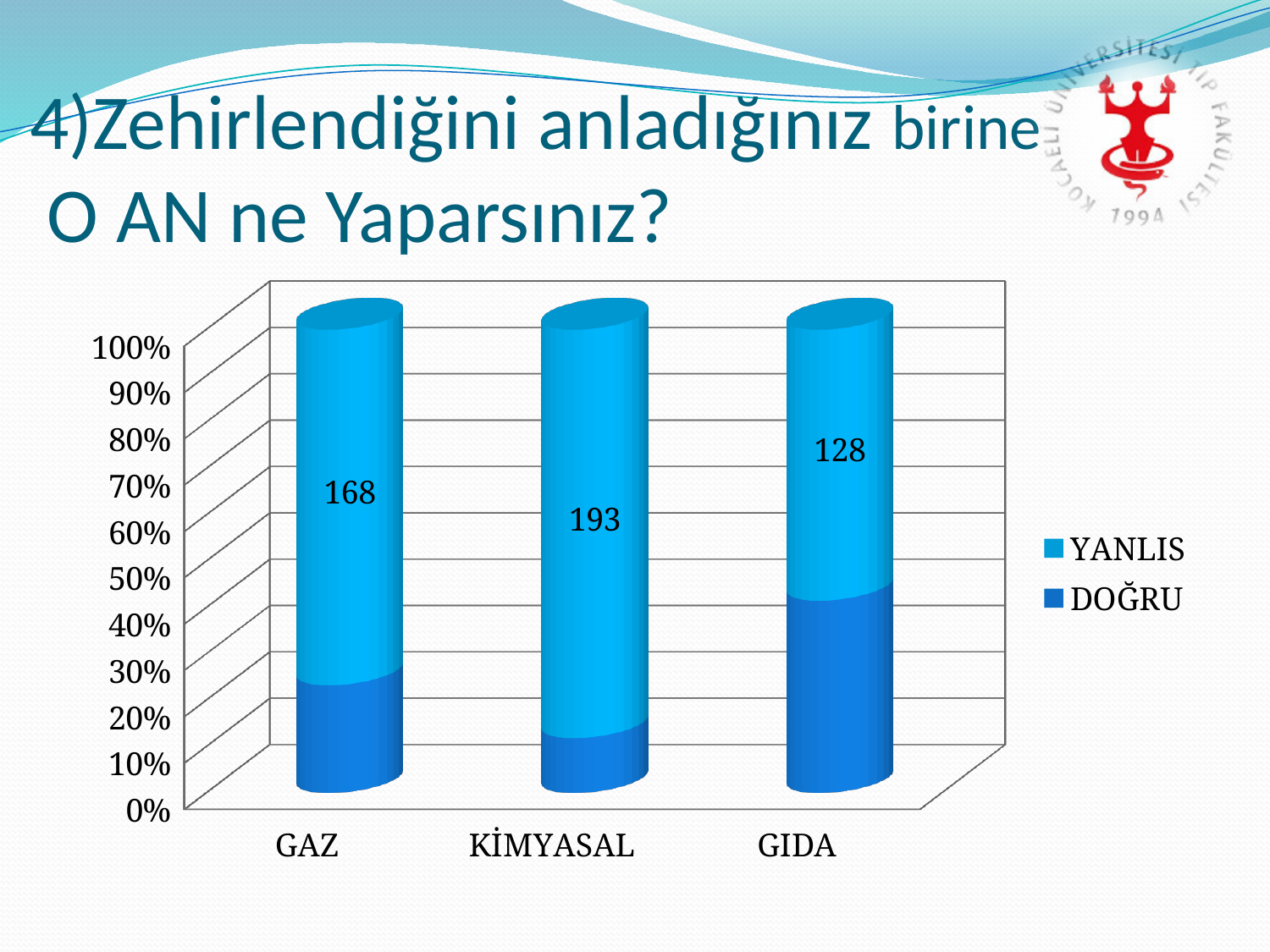
Is the DOĞRU share for GIDA greater or less than 40%? greater Is the DOĞRU share for KİMYASAL greater or less than 30%? less What is the YANLIS value for GAZ? 168 What kind of chart is shown on the slide? Stacked bar chart What is the YANLIS value for KİMYASAL? 193 Which category has the lowest YANLIS value? GIDA Which has a larger YANLIS value, GAZ or GIDA? GAZ How many categories are shown on the x axis? 3 What is the difference between the YANLIS values for KİMYASAL and GIDA? 65 How many series does the legend list? 2 Which category has the highest YANLIS value? KİMYASAL What is the YANLIS value for GIDA? 128